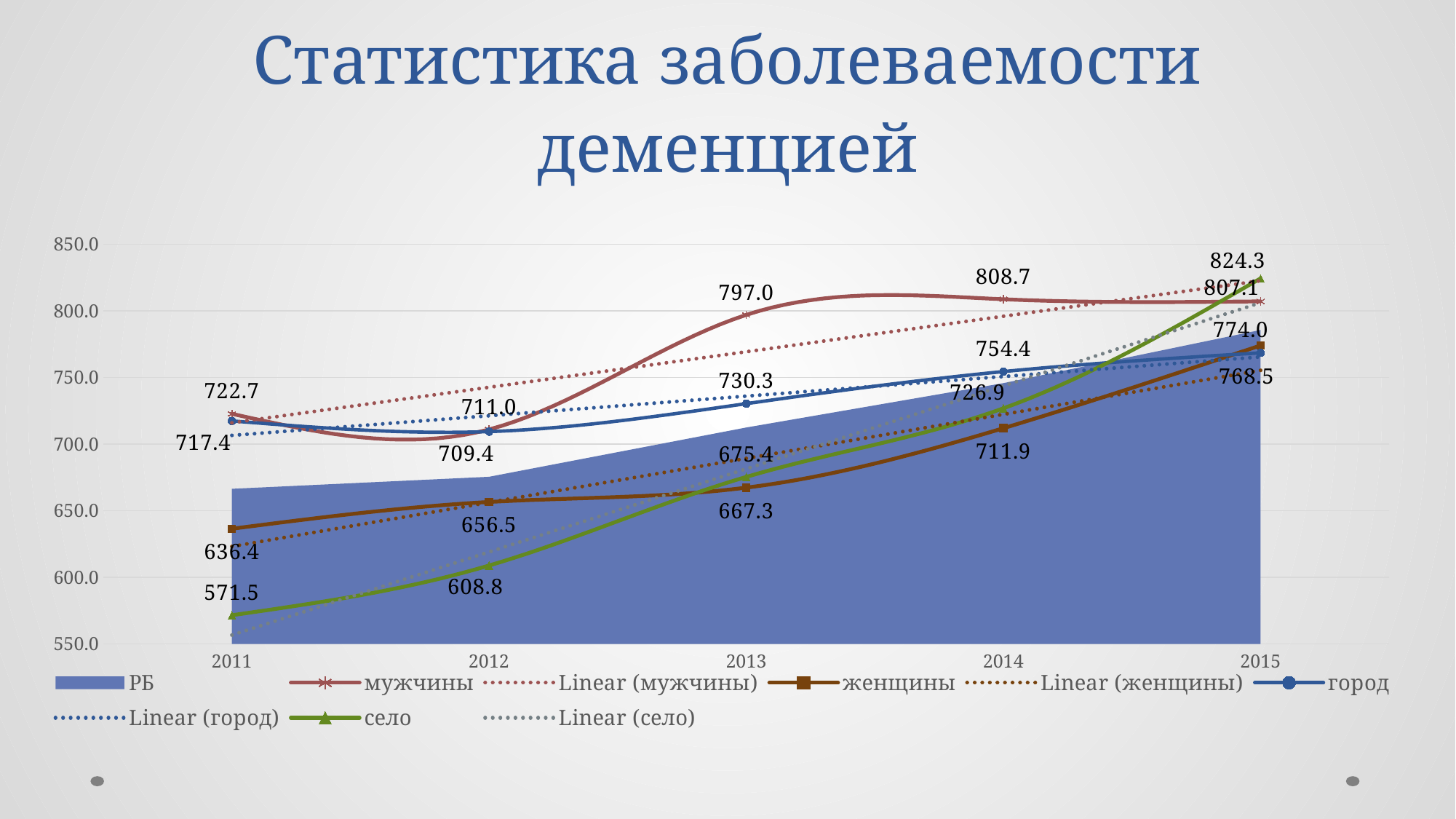
In which year is the value for мужчины highest? 2014 How many years are shown on the x axis? 5 What is the value for мужчины in 2013? 797.0 What is the value for женщины in 2012? 656.5 In which year is the value for село lowest? 2011 What is the value for село in 2011? 571.5 Is the value for РБ in 2011 greater or less than 700? less Does the value for село rise or fall from 2011 to 2015? rise Which is larger in 2013, the value for мужчины or the value for город? мужчины How many series does the legend list? 9 What is the difference between the село values in 2015 and 2011? 252.8 What is the value for город in 2014? 754.4